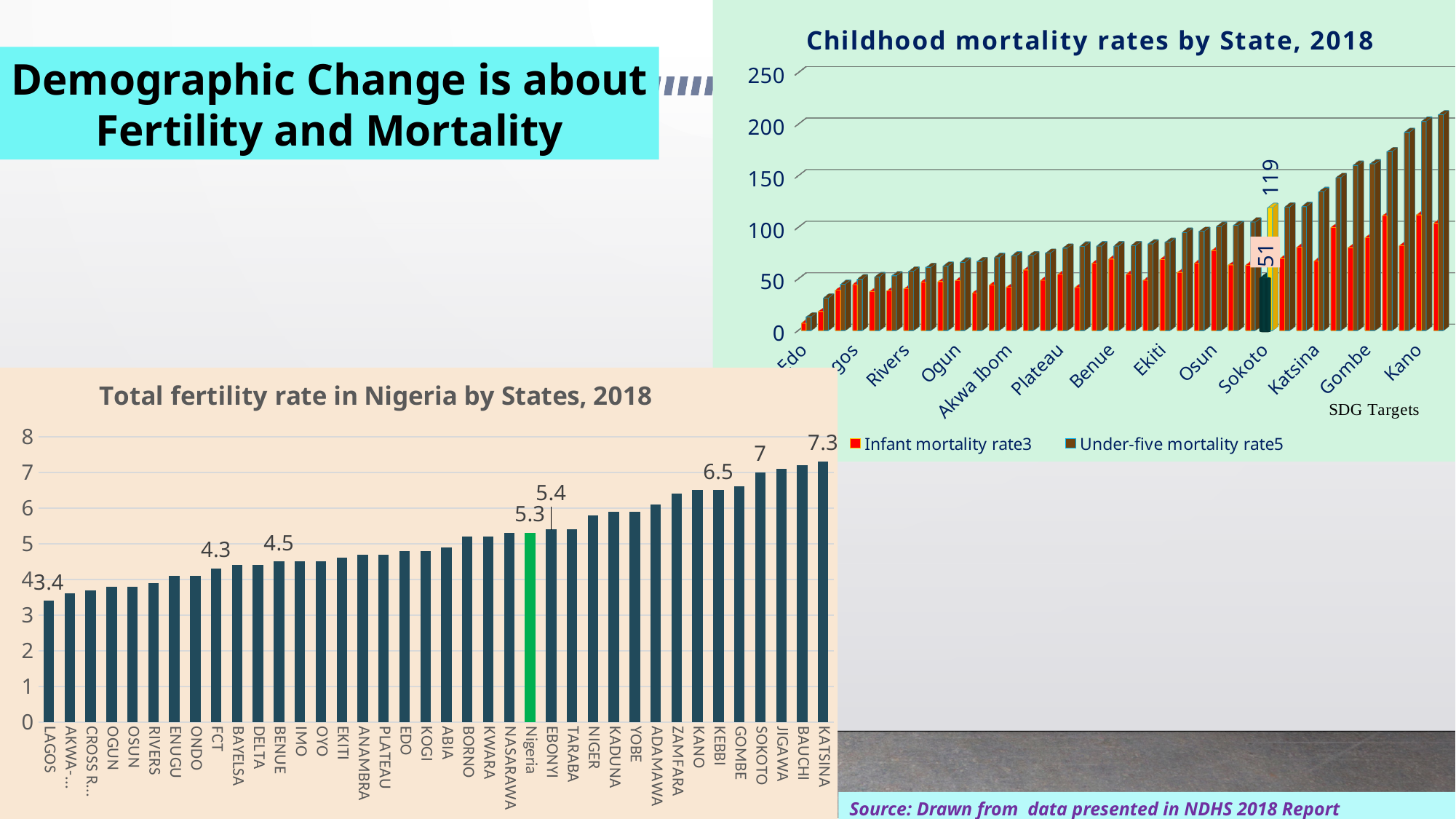
In the 'Total fertility rate in Nigeria by States, 2018' chart, what is the value for Benue? 4.5 In the 'Total fertility rate in Nigeria by States, 2018' chart, what is the value for Katsina? 7.3 In the 'Total fertility rate in Nigeria by States, 2018' chart, what is the difference between the values for Katsina and Lagos? 3.9 In the 'Total fertility rate in Nigeria by States, 2018' chart, which state has the highest fertility rate? Katsina In the 'Childhood mortality rates by State, 2018' chart, do the under-five mortality rates generally rise or fall from left to right along the x axis? rise How many series does the legend of the 'Childhood mortality rates by State, 2018' chart list? 2 In the 'Childhood mortality rates by State, 2018' chart, is the under-five mortality rate for Kano greater or less than 150? greater In the 'Total fertility rate in Nigeria by States, 2018' chart, what is the value for Nigeria (the green bar)? 5.3 What kind of chart is 'Total fertility rate in Nigeria by States, 2018'? bar chart In the 'Total fertility rate in Nigeria by States, 2018' chart, what is the value for Sokoto? 7 In the 'Total fertility rate in Nigeria by States, 2018' chart, what is the value for Lagos? 3.4 In the 'Total fertility rate in Nigeria by States, 2018' chart, which state has the lowest fertility rate? Lagos